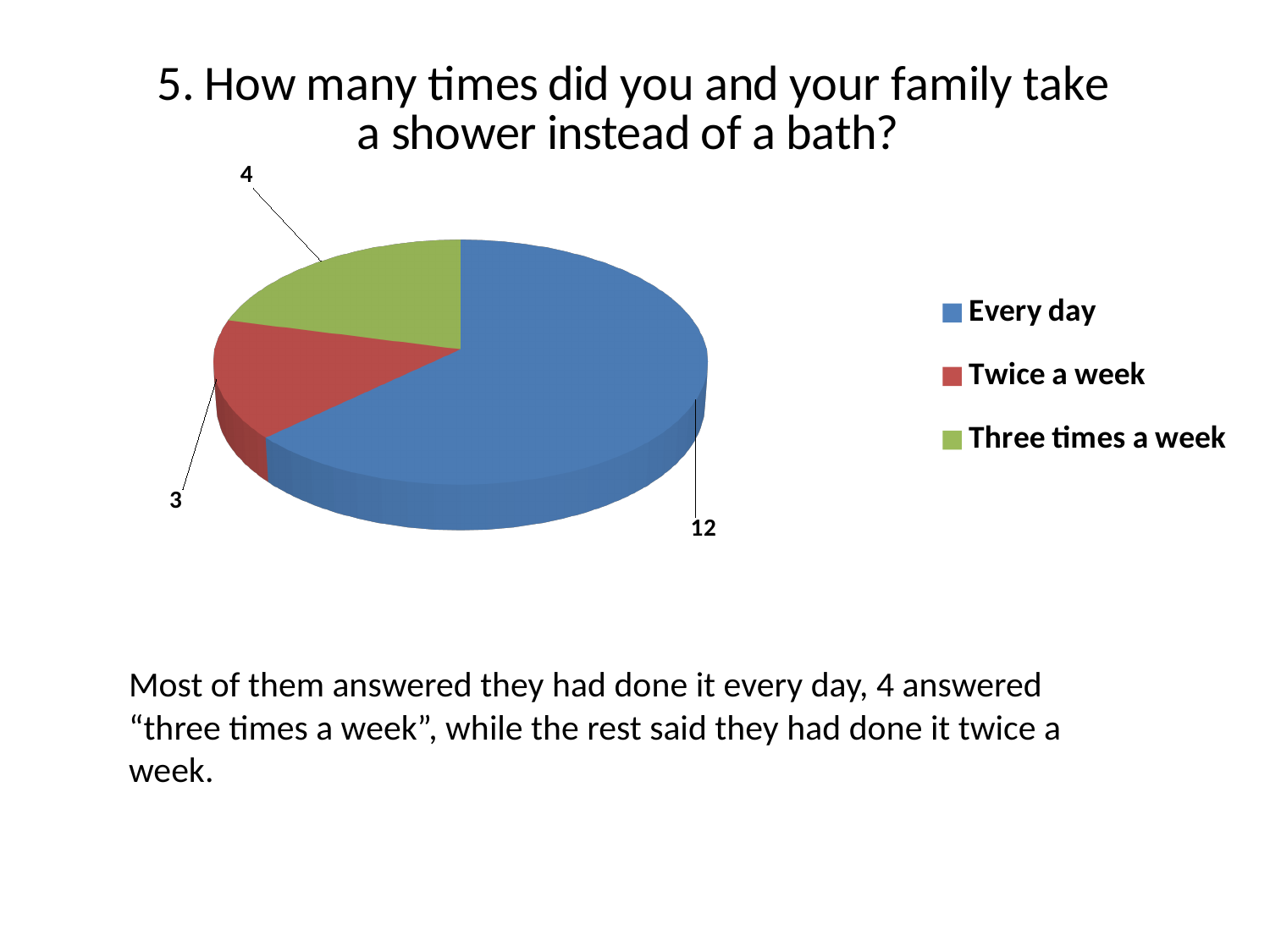
Which is larger: the number who answered "Three times a week" or the number who answered "Twice a week"? Three times a week How many people answered "Three times a week"? 4 What kind of chart is shown on the slide? Pie chart Which answer has the smallest slice of the pie? Twice a week Which legend entry is shown in green? Three times a week How many people answered "Every day"? 12 Which answer has the largest slice of the pie? Every day How many people answered "Twice a week"? 3 What colour is the "Every day" slice? Blue What is the difference between the number who answered "Every day" and the number who answered "Three times a week"? 8 What is the total number of responses shown in the pie chart? 19 How many categories does the pie chart have? 3